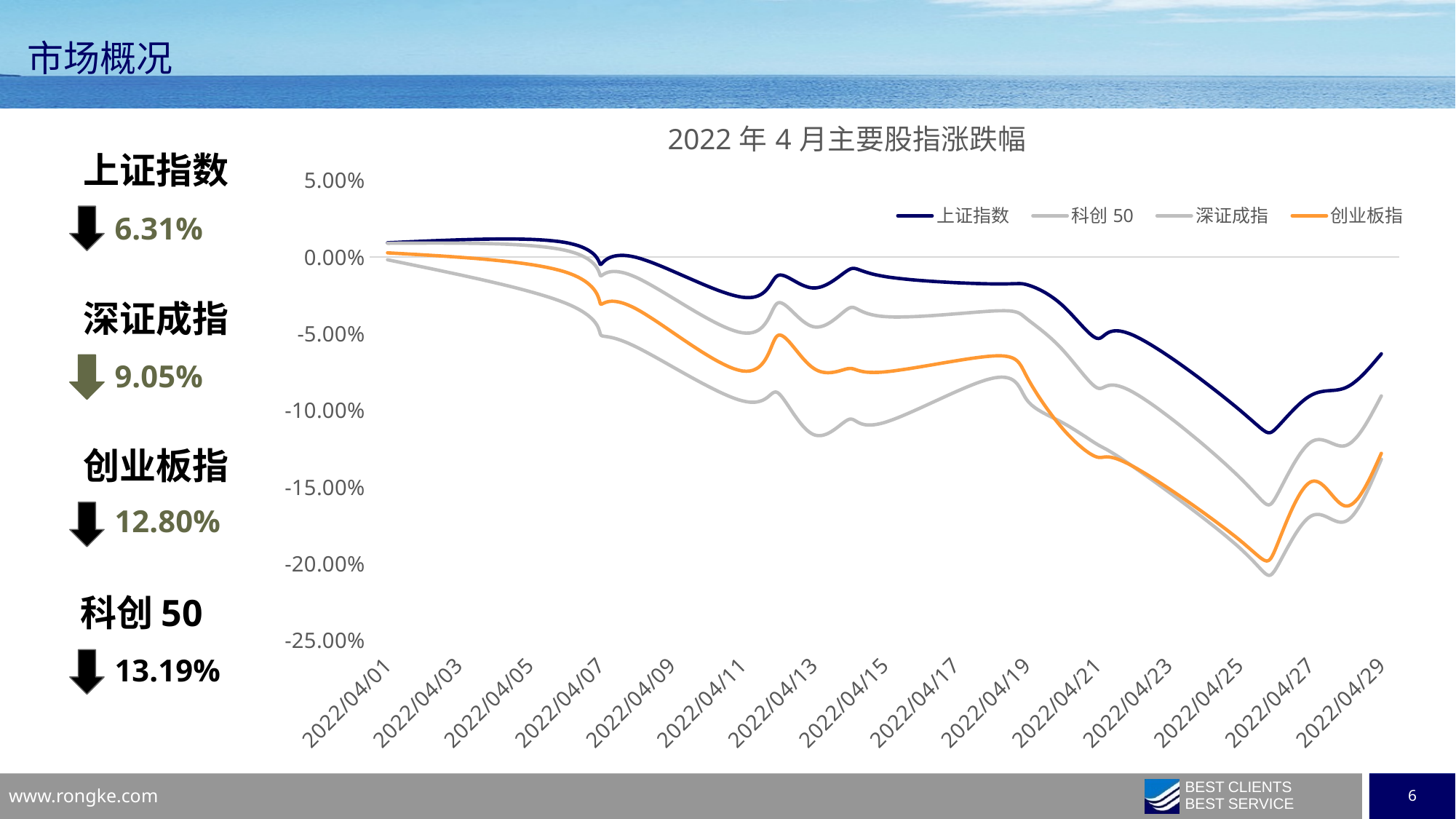
Is the value of 上证指数 on 2022/04/29 greater or less than -10.00%? greater What kind of chart is shown on the slide? line chart What is the lowest tick value shown on the y axis of the chart? -25.00% What is the title of the chart? 2022 年 4 月主要股指涨跌幅 Which series is drawn in orange in the chart? 创业板指 Is the value of 上证指数 on 2022/04/13 greater or less than -5.00%? greater How many date labels are shown on the x axis of the chart? 15 How many series does the chart legend list? 4 Which series has the highest value on 2022/04/29 in the chart? 上证指数 Is the value of 创业板指 on 2022/04/29 greater or less than -10.00%? less Overall, do the index values in the chart rise or fall from 2022/04/01 to 2022/04/29? fall On 2022/04/29, which is higher in the chart: 上证指数 or 创业板指? 上证指数